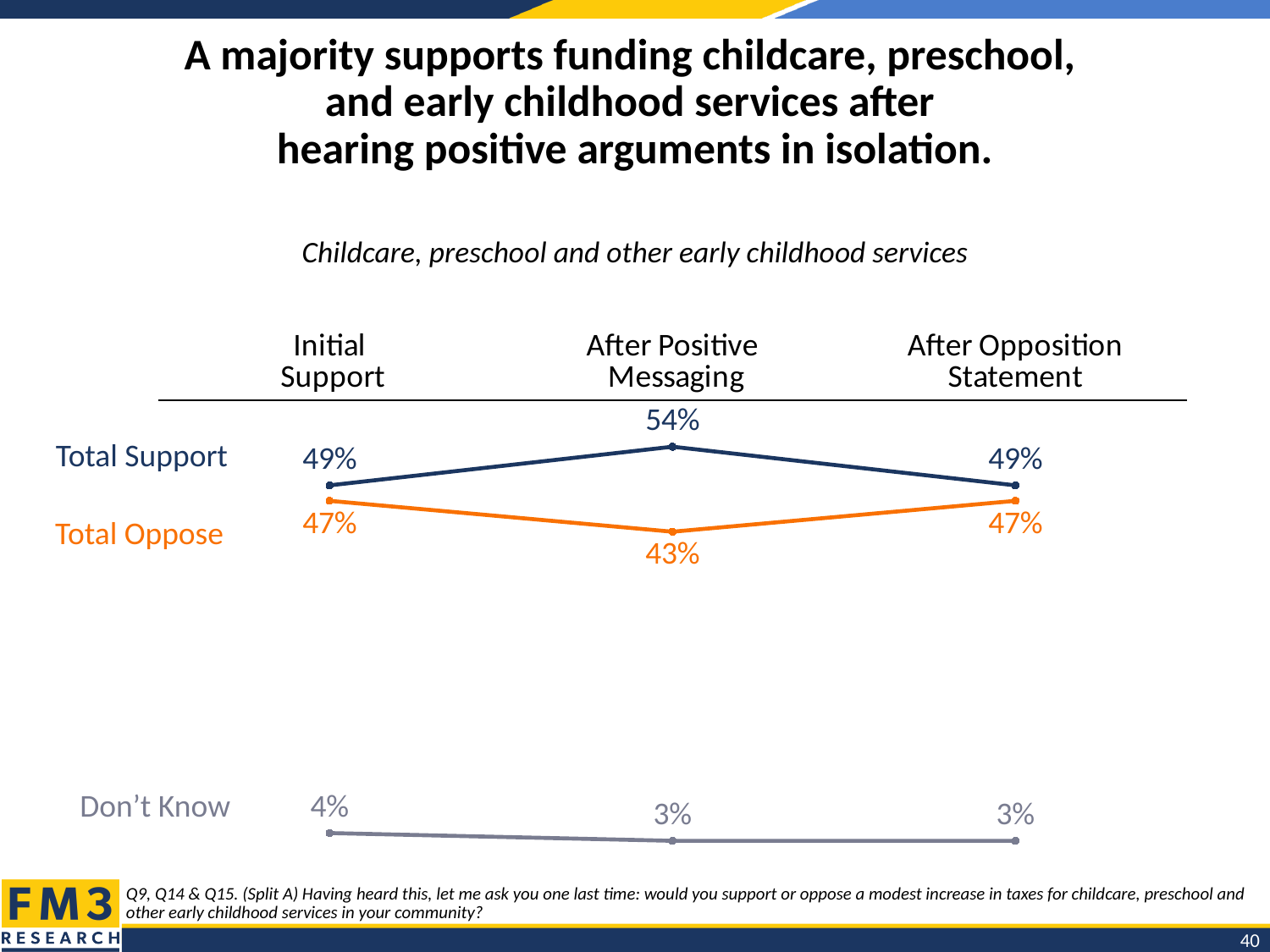
What is the Total Oppose value after positive messaging? 43% What kind of chart is shown on the slide? Line chart How many series are plotted on the chart? 3 Which is larger after the opposition statement, Total Support or Total Oppose? Total Support At which stage is Total Oppose lowest? After Positive Messaging Does the Don't Know line rise or fall from Initial Support to After Positive Messaging? Fall What is the Total Support value after positive messaging? 54% What is the Total Oppose value at initial support? 47% What is the difference between Total Support and Total Oppose after positive messaging? 11 percentage points At which stage is Total Support highest? After Positive Messaging How many stages are plotted along the x axis? 3 What is the Don't Know value after the opposition statement? 3%